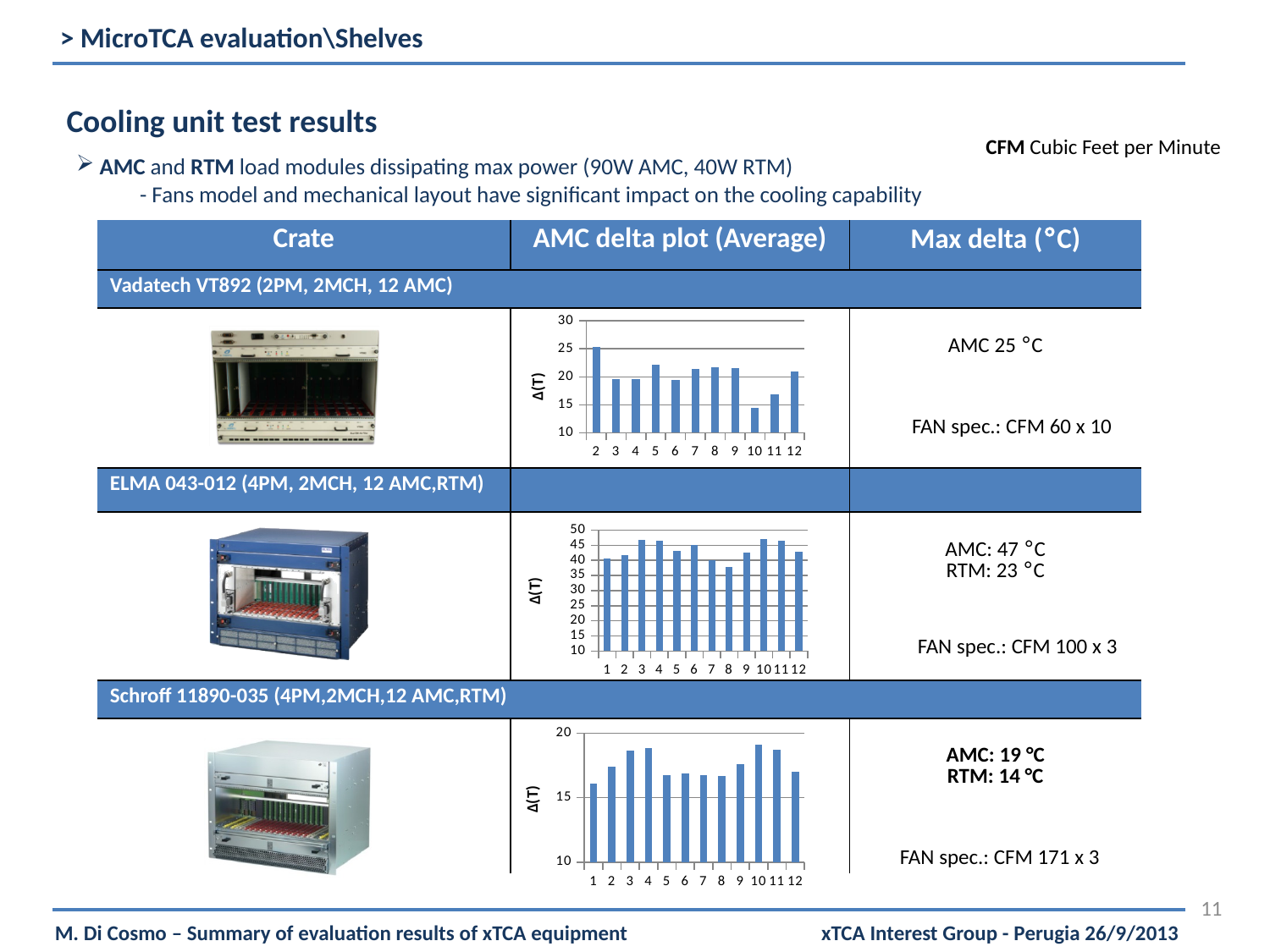
In the Vadatech VT892 AMC delta plot, is the value for slot 2 greater or less than 20? greater In the ELMA 043-012 AMC delta plot, which slot number has the lowest bar? 8 In the Schroff 11890-035 AMC delta plot, which slot number has the lowest bar? 1 What kind of chart is shown in the AMC delta plot for the Vadatech VT892 crate? bar chart In the Vadatech VT892 AMC delta plot, which slot number has the highest bar? 2 In the ELMA 043-012 AMC delta plot, is the value for slot 4 greater or less than 40? greater In the Vadatech VT892 AMC delta plot, which slot number has the lowest bar? 10 In the Schroff 11890-035 AMC delta plot, is the value for slot 1 greater or less than 15? greater In the ELMA 043-012 AMC delta plot, how many slots are plotted on the x axis? 12 What label is shown on the y axis of the three AMC delta plots? Δ(T) In the Vadatech VT892 AMC delta plot, how many bars (AMC slots) are plotted? 11